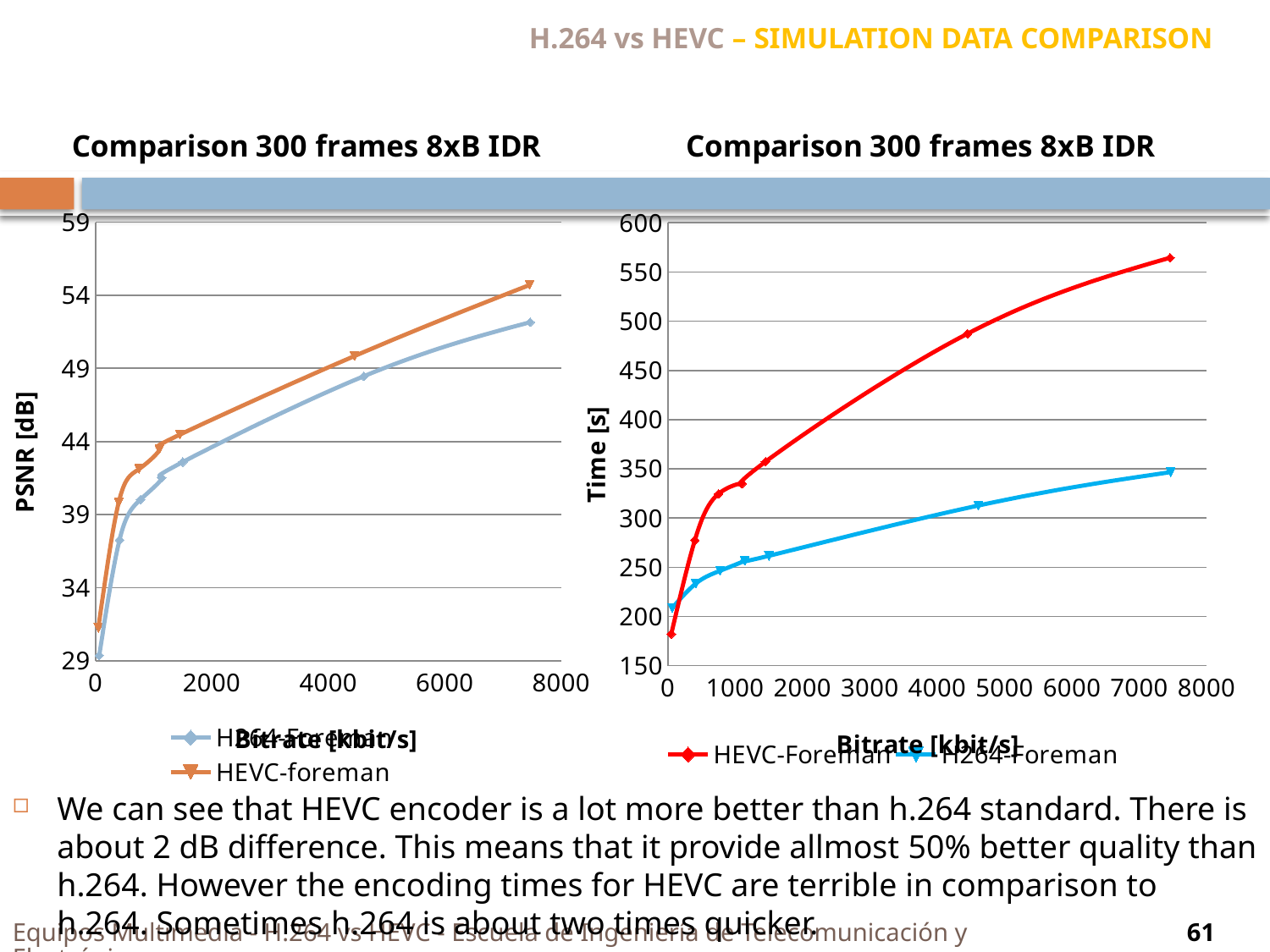
In the right chart, is the time for HEVC-Foreman at the highest bitrate greater or less than 550? greater What is the label of the y axis of the right chart? Time [s] In the left chart, is the PSNR value of HEVC-foreman at the highest bitrate greater or less than 54? greater What type of chart is the left chart on the slide? line chart In the right chart, is the time for HEVC-Foreman at the lowest bitrate greater or less than 200? less What type of chart is the right chart on the slide? line chart In the left chart, do the PSNR values rise or fall as bitrate increases? rise How many series does the legend of the left chart list? 2 In the right chart, which series has the higher time at the highest bitrate, HEVC-Foreman or H264-Foreman? HEVC-Foreman How many series does the legend of the right chart list? 2